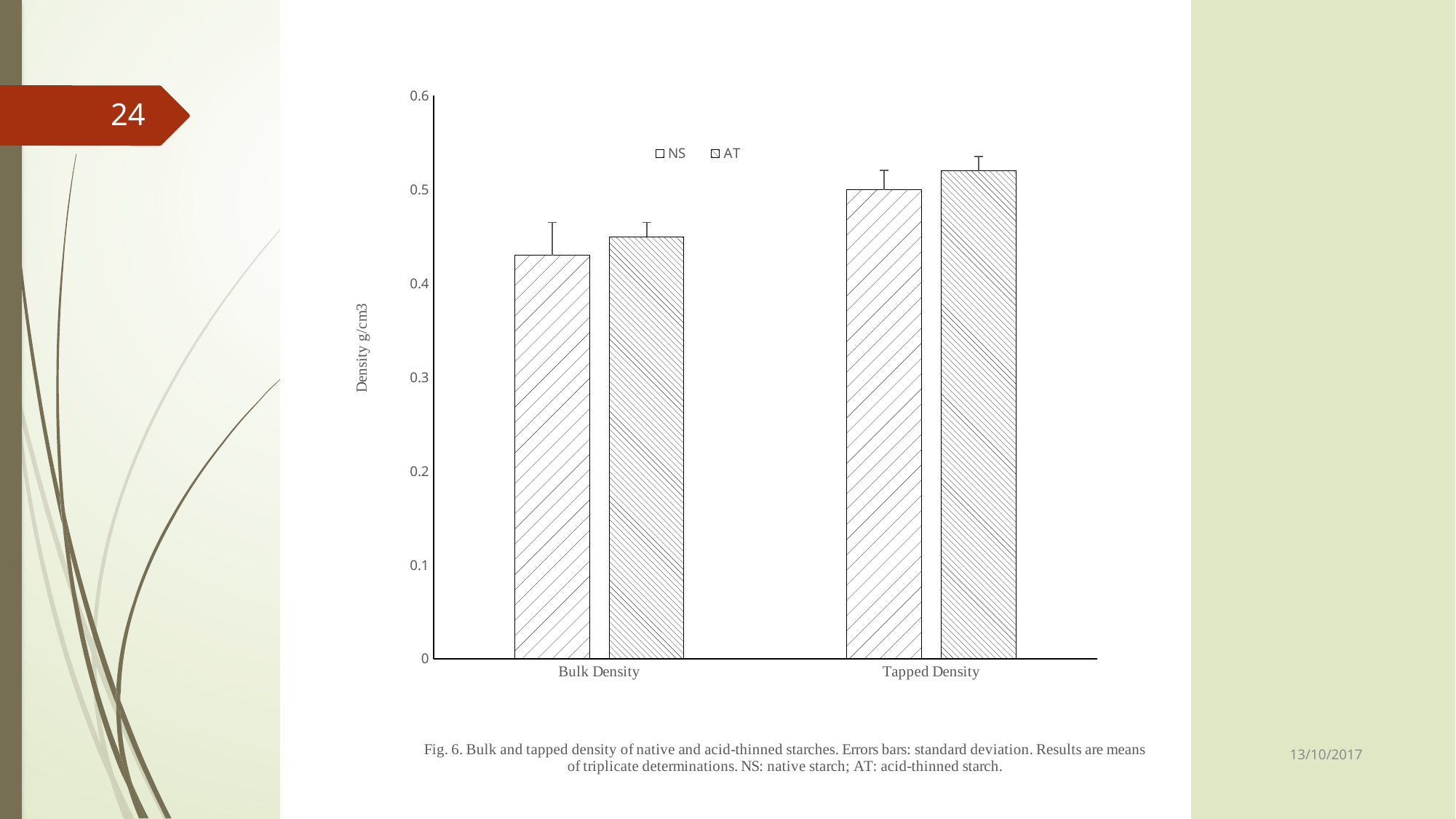
Is the NS value for Bulk Density greater or less than 0.5? less What are the two series named in the legend? NS and AT Is the NS value for Bulk Density greater or less than 0.4? greater What kind of chart is shown on the slide? bar chart How many categories are shown on the x axis of the chart? 2 Which category has the higher NS value, Bulk Density or Tapped Density? Tapped Density Do the values rise or fall going from Bulk Density to Tapped Density along the x axis? rise What is the label on the vertical axis of the chart? Density g/cm3 Is the AT value for Bulk Density greater or less than 0.5? less How many series does the chart's legend list? 2 Which bar in the chart is the tallest? AT for Tapped Density